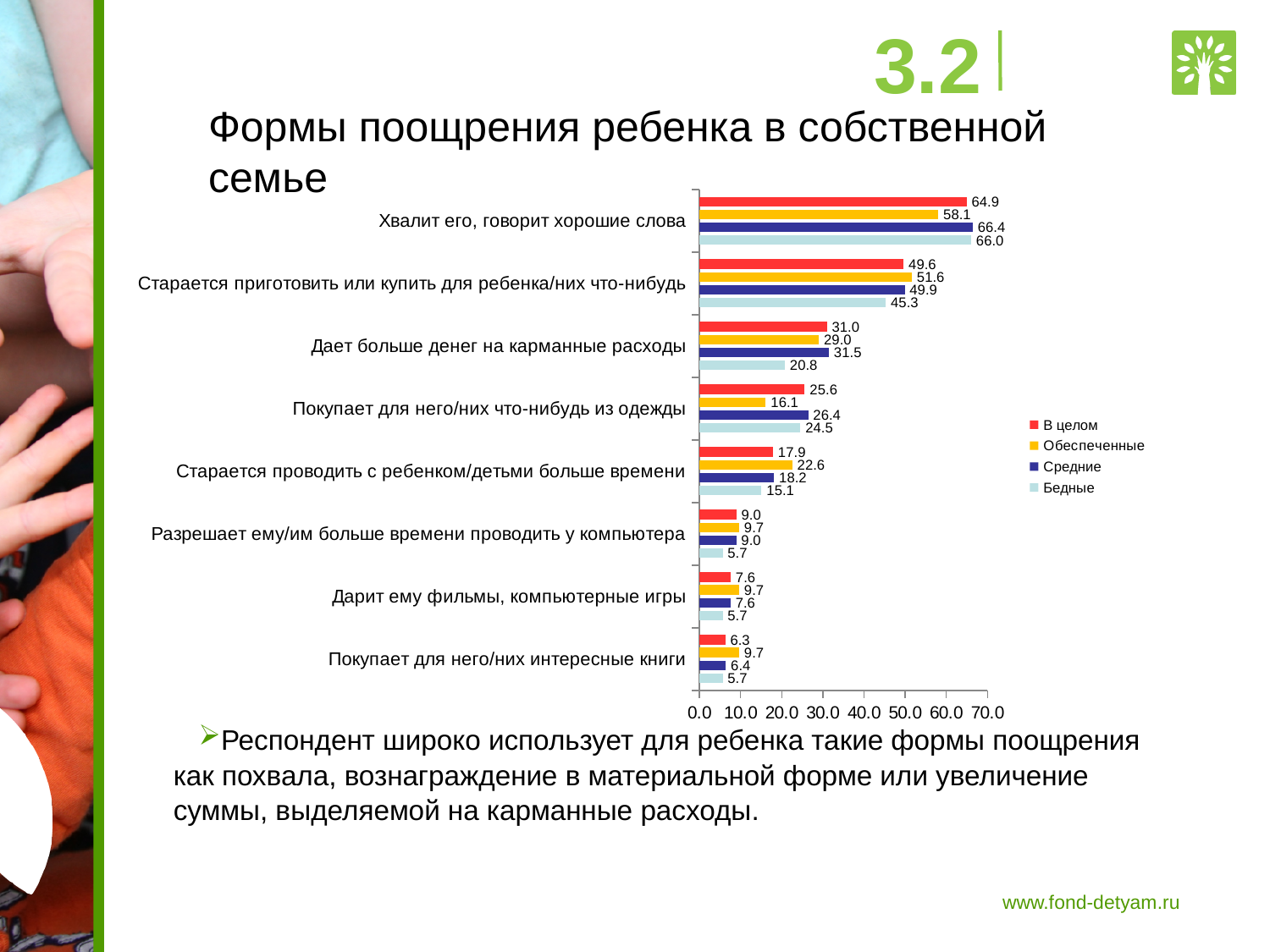
What is the difference between the "Обеспеченные" and "Бедные" values in the category "Старается проводить с ребенком/детьми больше времени"? 7.5 Which category has the lowest value for the "В целом" series? Покупает для него/них интересные книги What is the value for "Обеспеченные" in the category "Покупает для него/них что-нибудь из одежды"? 16.1 In the category "Старается приготовить или купить для ребенка/них что-нибудь", which is larger: the value for "Обеспеченные" or for "Бедные"? Обеспеченные Is the value for "Средние" in the category "Дает больше денег на карманные расходы" greater or less than 30.0? greater What is the value for "В целом" in the category "Хвалит его, говорит хорошие слова"? 64.9 What is the value for "Бедные" in the category "Дает больше денег на карманные расходы"? 20.8 Which series is shown in red in the legend? В целом Which category has the highest value for the "Средние" series? Хвалит его, говорит хорошие слова How many series does the legend list? 4 How many categories are shown on the chart? 8 What type of chart is shown on the slide? Bar chart